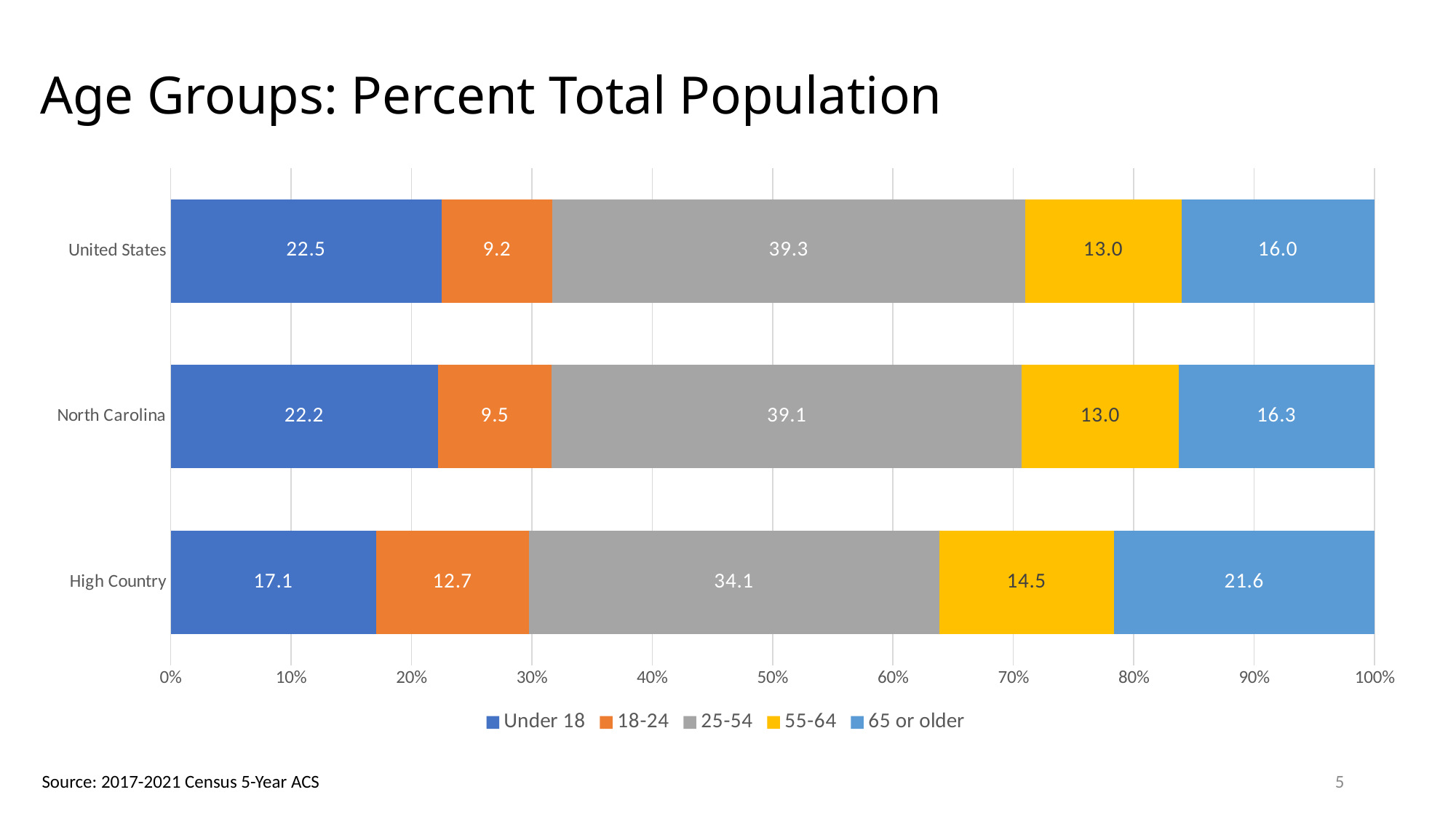
What kind of chart is shown on the slide? Stacked bar chart What is the title of the chart? Age Groups: Percent Total Population What is the value for the 65 or older age group in the United States? 16.0 How many regions are shown on the chart? 3 Which region has the lowest value for the Under 18 age group? High Country How many age groups does the legend list? 5 Which is larger, the 55-64 value for High Country or for North Carolina? High Country What is the difference between the 18-24 values for High Country and the United States? 3.5 What is the value for the 25-54 age group in High Country? 34.1 What is the value for the 18-24 age group in North Carolina? 9.5 Which region has the highest value for the 65 or older age group? High Country What is the total of the stacked bar for the United States? 100.0